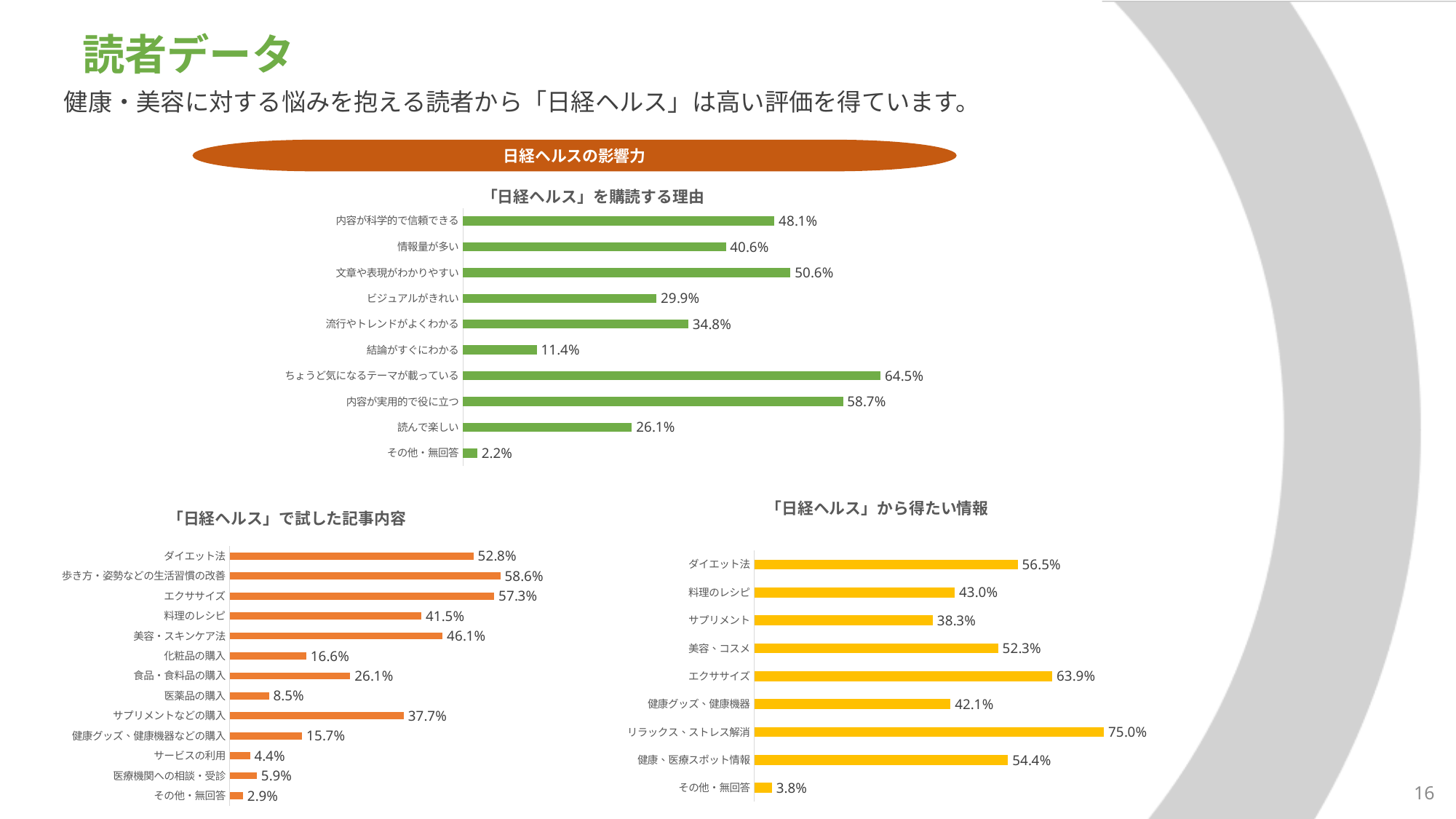
In the chart 「日経ヘルス」を購読する理由, which category has the highest value? ちょうど気になるテーマが載っている In the chart 「日経ヘルス」から得たい情報, what is the value for リラックス、ストレス解消? 75.0% In the chart 「日経ヘルス」を購読する理由, which category has the lowest value? その他・無回答 How many categories are shown in the chart 「日経ヘルス」を購読する理由? 10 In the chart 「日経ヘルス」を購読する理由, what is the value for 内容が科学的で信頼できる? 48.1% In the chart 「日経ヘルス」で試した記事内容, which is larger, 料理のレシピ or 美容・スキンケア法? 美容・スキンケア法 In the chart 「日経ヘルス」で試した記事内容, which category has the highest value? 歩き方・姿勢などの生活習慣の改善 In the chart 「日経ヘルス」で試した記事内容, what is the value for サプリメントなどの購入? 37.7% What type of chart is 「日経ヘルス」から得たい情報? Bar chart How many categories are shown in the chart 「日経ヘルス」で試した記事内容? 13 In the chart 「日経ヘルス」から得たい情報, what is the difference between エクササイズ and サプリメント? 25.6% In the chart 「日経ヘルス」を購読する理由, what is the difference between ちょうど気になるテーマが載っている and 内容が実用的で役に立つ? 5.8%